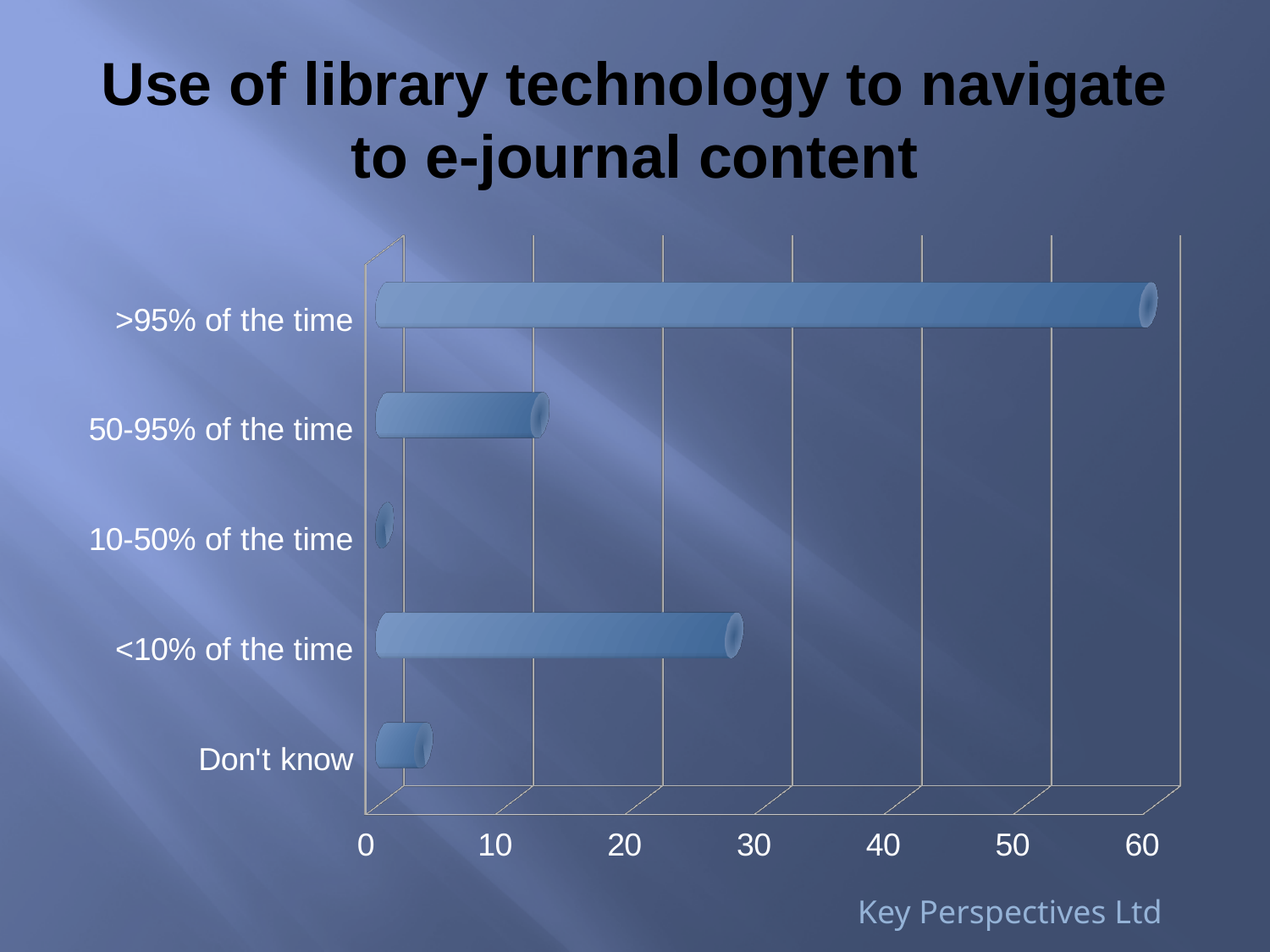
Is the value for '<10% of the time' greater or less than 20? greater Which category has the highest value? >95% of the time What kind of chart is shown on the slide? bar chart Is the value for 'Don't know' greater or less than 10? less Is the value for '50-95% of the time' greater or less than 10? greater Which is larger, the value for 'Don't know' or the value for '10-50% of the time'? Don't know What is the title of the chart? Use of library technology to navigate to e-journal content Which category has the lowest value? 10-50% of the time Which is larger, the value for '<10% of the time' or the value for '50-95% of the time'? <10% of the time How many categories are plotted in the chart? 5